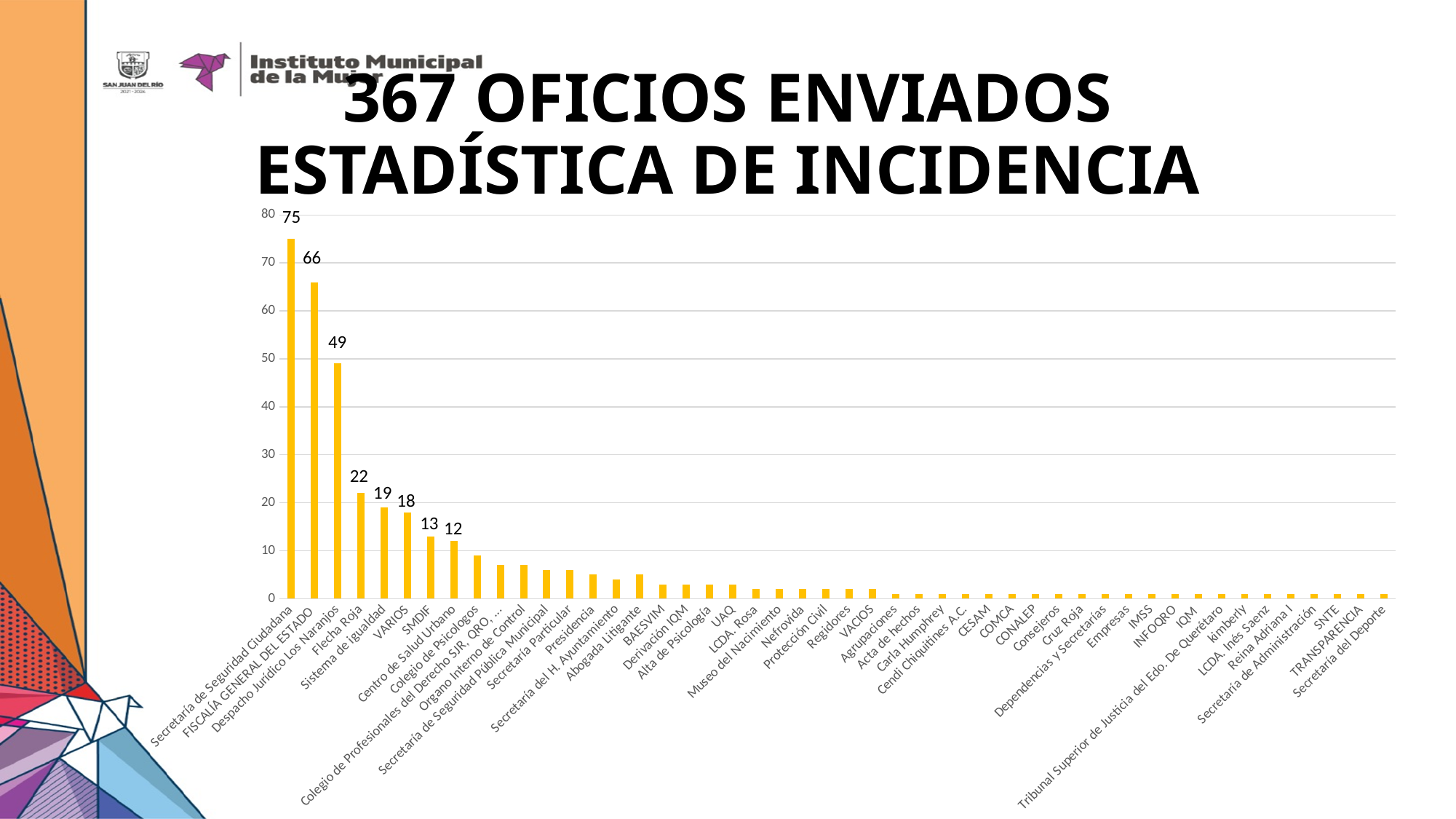
What is the value for SMDIF? 13 What is the value for Despacho Jurídico Los Naranjos? 49 Is the value for Colegio de Psicólogos greater or less than 10? less What is the value for FISCALÍA GENERAL DEL ESTADO? 66 What colour are the bars in the chart? Yellow Which is larger, the value for Sistema de Igualdad or the value for VARIOS? Sistema de Igualdad What is the value for Secretaría de Seguridad Ciudadana? 75 Do the values rise or fall moving from left to right along the x axis? Fall What kind of chart is shown on the slide? Bar chart What is the value for Flecha Roja? 22 Which category has the highest value? Secretaría de Seguridad Ciudadana What is the difference between the values for Secretaría de Seguridad Ciudadana and FISCALÍA GENERAL DEL ESTADO? 9